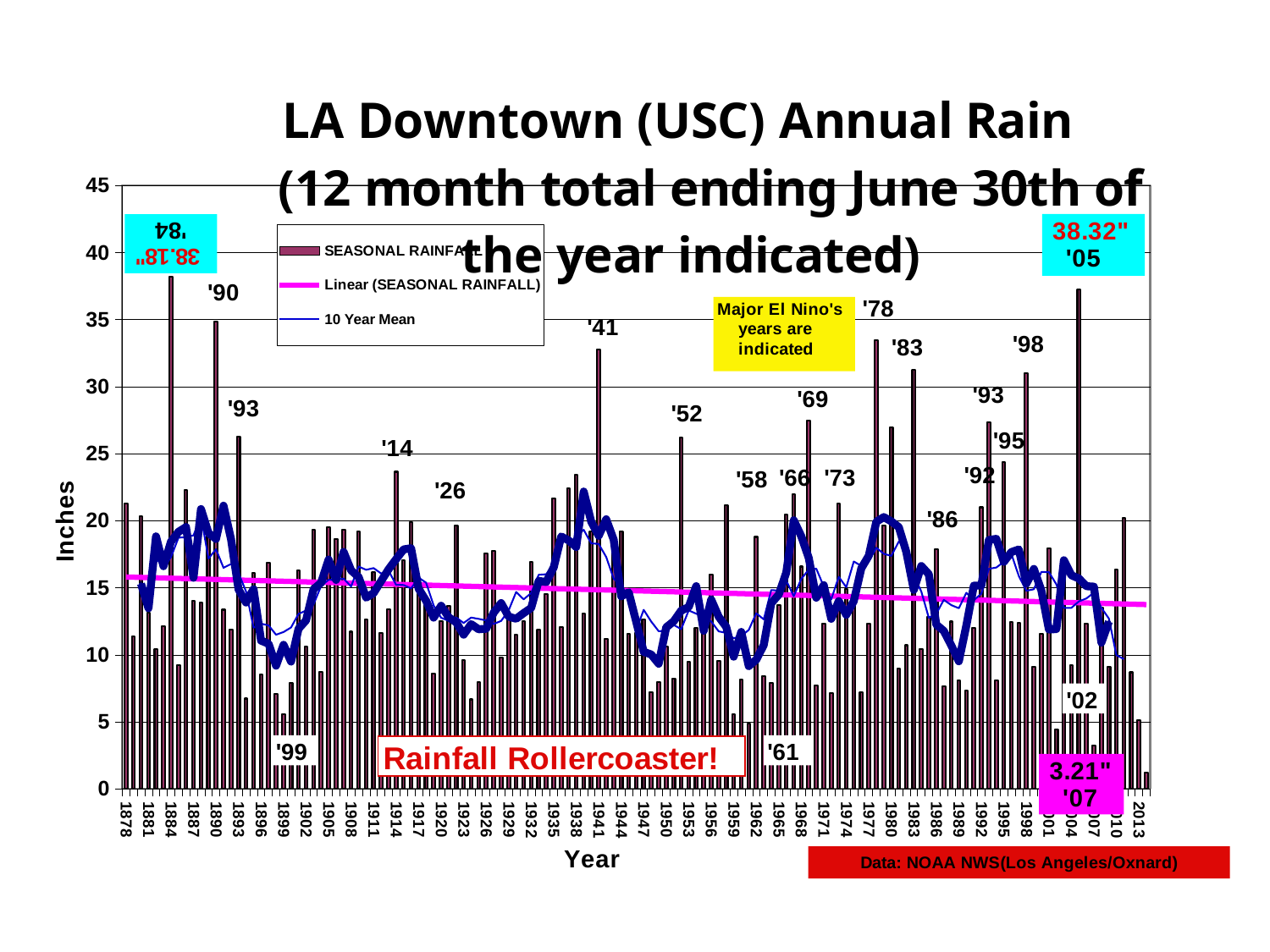
Is the rainfall value for 1941 greater or less than 30 inches? greater What is the label on the y-axis of the chart? Inches Which had more rainfall, the 2005 season or the 1884 season? 2005 What kind of chart is used to show the seasonal rainfall values? Bar chart How many series does the legend list? 3 What was the annual rainfall for the season ending in 2007? 3.21" Is the rainfall value for 1961 greater or less than 10 inches? less What was the annual rainfall for the season ending in 2005? 38.32" What was the annual rainfall for the season ending in 1884? 38.18" What is the difference in rainfall between the 2005 season (38.32") and the 2007 season (3.21")? 35.11" Does the linear trend line for seasonal rainfall rise or fall from 1878 to 2013? Falls